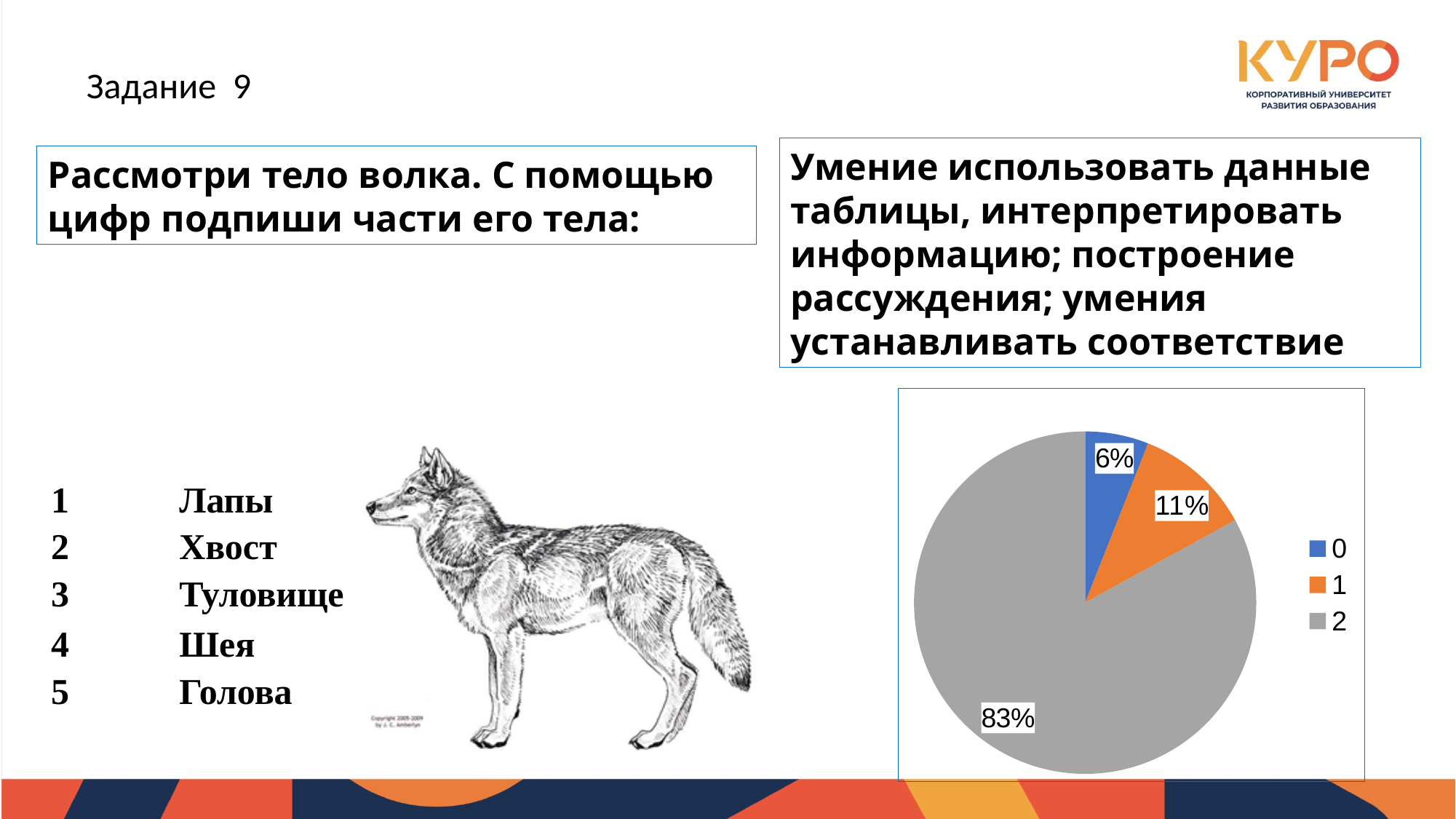
What percentage does the slice labelled 1 represent in the pie chart? 11% What percentage does the slice labelled 2 represent in the pie chart? 83% What percentage does the slice labelled 0 represent in the pie chart? 6% How many categories does the legend of the pie chart list? 3 Which category has the smallest slice in the pie chart? 0 Which category has the largest slice in the pie chart? 2 What colour is the slice for category 2 in the pie chart? grey What is the difference in percentage points between the slices for 1 and 0? 5 What colour is the slice for category 0 in the pie chart? blue What kind of chart is shown on the slide? pie chart What is the difference in percentage points between the slices for 2 and 1? 72 Which slice is larger, the one for 1 or the one for 0? 1